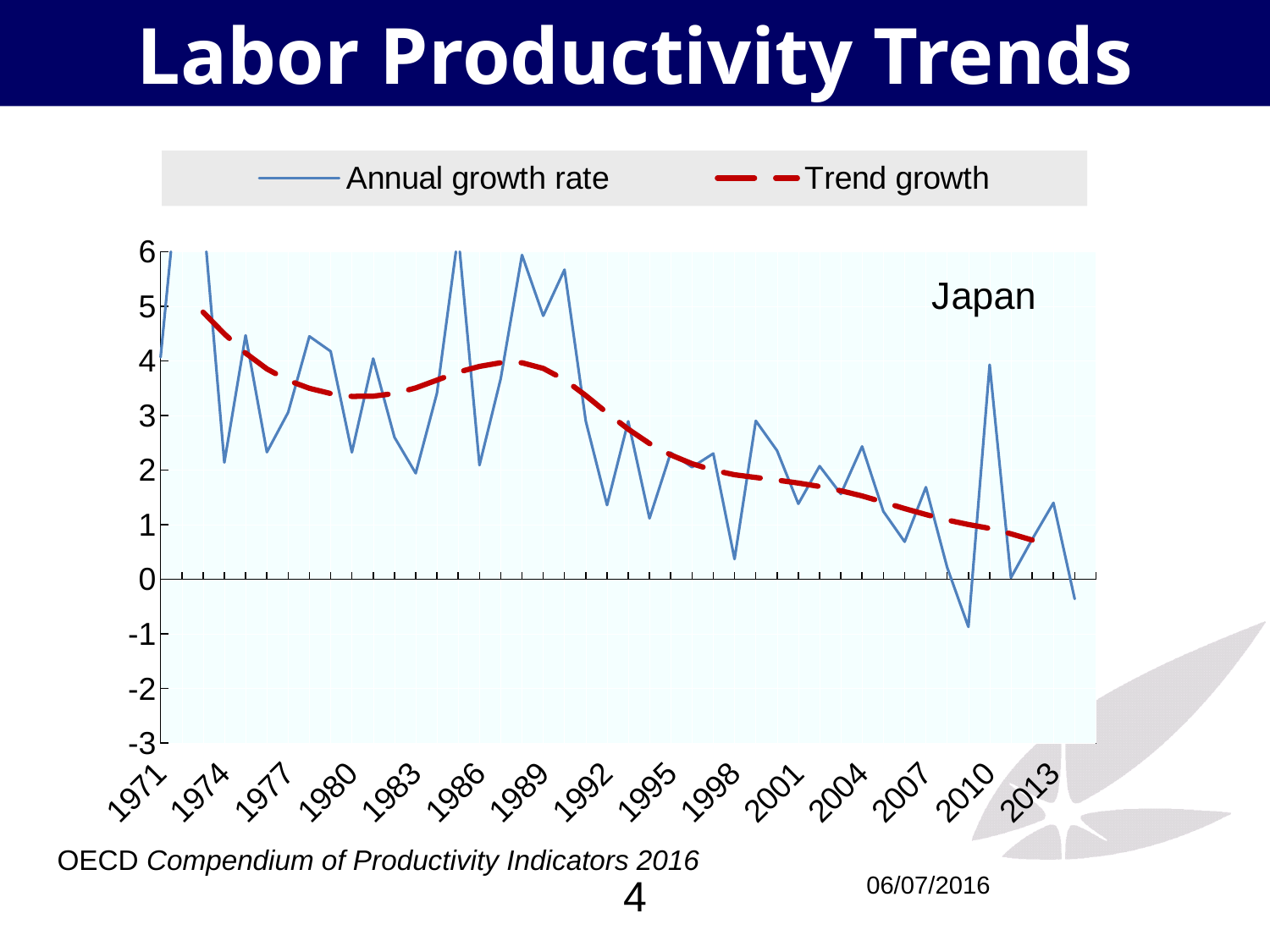
How many series does the legend list? 2 Is the Annual growth rate for 2010 greater or less than 0? greater Is the Trend growth value for 1974 greater or less than 4? greater What kind of chart is shown on the slide? line chart Does the Trend growth line rise or fall overall from 1971 to 2013? fall Which is larger, the Annual growth rate in 2010 or in 2011? 2010 Is the Annual growth rate for 2011 greater or less than 3? less Which series is drawn as a red dashed line? Trend growth Which country does the chart show labor productivity trends for? Japan